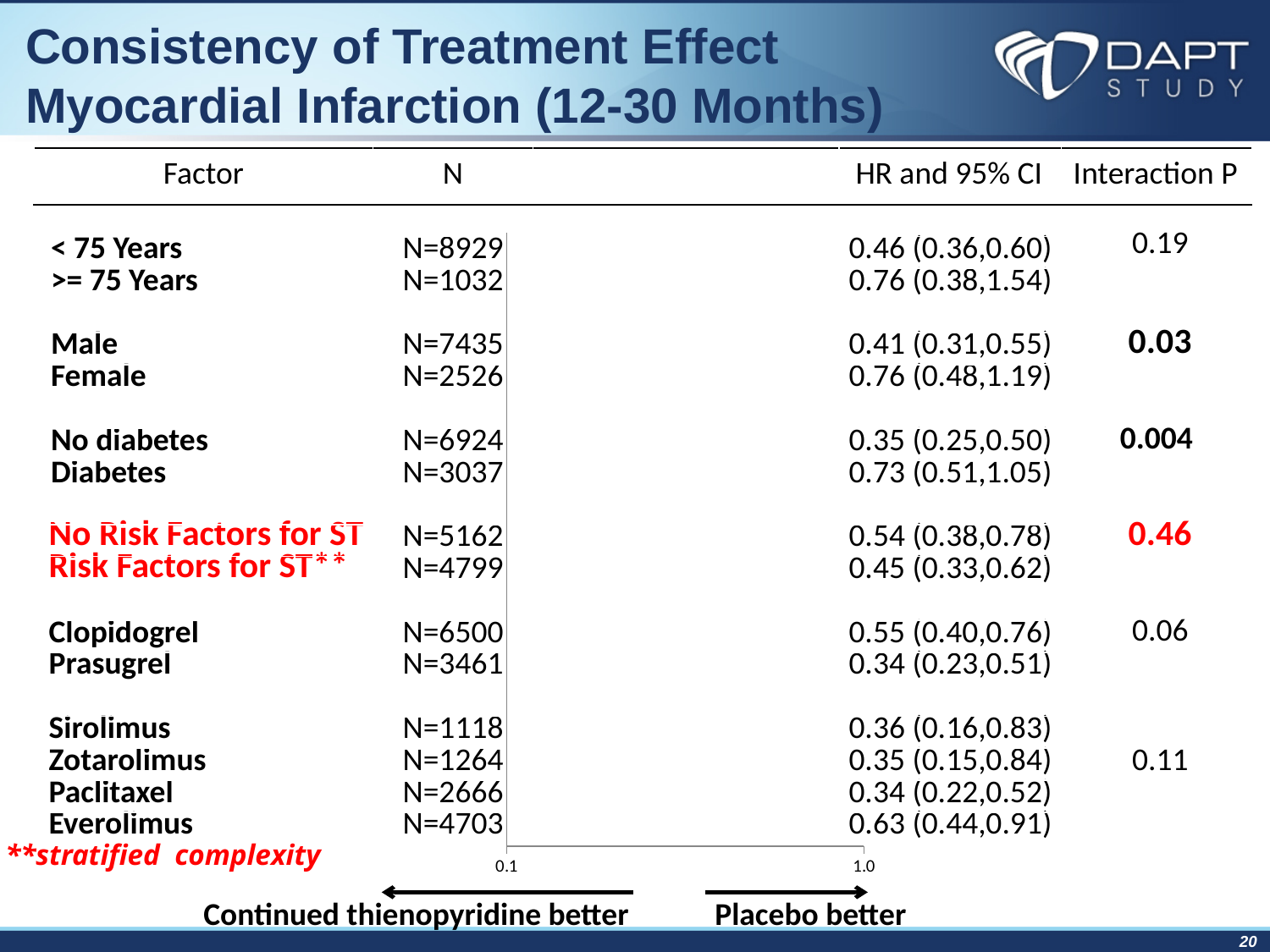
What is the interaction P value for the diabetes subgroup comparison (No diabetes vs Diabetes)? 0.004 Is the hazard ratio for Everolimus greater or less than 1.0? less How many factor rows are listed in the forest plot? 14 Which subgroup comparison has the lowest interaction P value? No diabetes / Diabetes What is the hazard ratio and 95% CI shown for Everolimus? 0.63 (0.44,0.91) What is the hazard ratio shown for Male patients? 0.41 (0.31,0.55) What is the N for the Clopidogrel subgroup? N=6500 Which has the higher hazard ratio, Male or Female? Female Which factor has the largest N? < 75 Years What does the left side of the x axis (toward 0.1) indicate, according to the label below the chart? Continued thienopyridine better What is the difference between the hazard ratio for Female (0.76) and Male (0.41)? 0.35 What kind of chart is shown on the slide? Forest plot